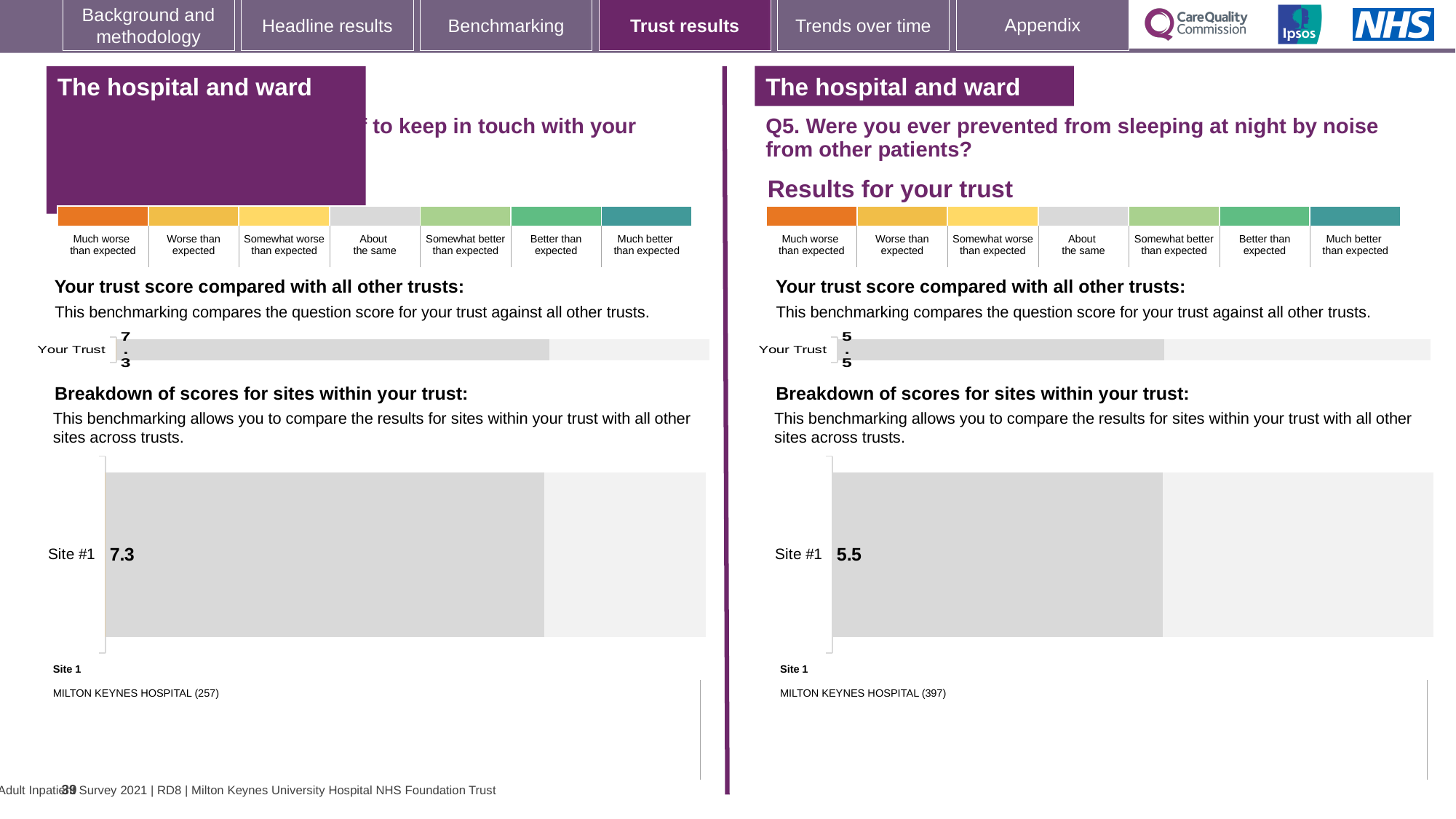
On the left-hand side of the slide, what is the 'Your Trust' score in the chart comparing the trust score with all other trusts? 7.3 What is the difference between the Site #1 score on the left-hand chart (7.3) and the Site #1 score on the right-hand chart (5.5)? 1.8 How many sites are shown in the breakdown of scores chart on the right-hand side of the slide (Q5)? 1 Which is larger: the Site #1 score on the left-hand chart or the Site #1 score on the right-hand chart (Q5)? The left-hand chart (7.3) What type of chart is used for the breakdown of scores for sites within your trust on the right-hand side of the slide? Bar chart On the right-hand side of the slide (Q5), which hospital is listed as Site 1 below the chart? MILTON KEYNES HOSPITAL (397) On the right-hand side of the slide (Q5), what is the 'Your Trust' score in the chart comparing the trust score with all other trusts? 5.5 How many sites are shown in the breakdown of scores chart on the left-hand side of the slide? 1 On the left-hand side of the slide, which hospital is listed as Site 1 below the chart? MILTON KEYNES HOSPITAL (257) On the right-hand side of the slide (Q5, prevented from sleeping at night by noise from other patients), what is the score shown for Site #1? 5.5 On the left-hand side of the slide, what is the score shown for Site #1 in the breakdown of scores for sites within your trust? 7.3